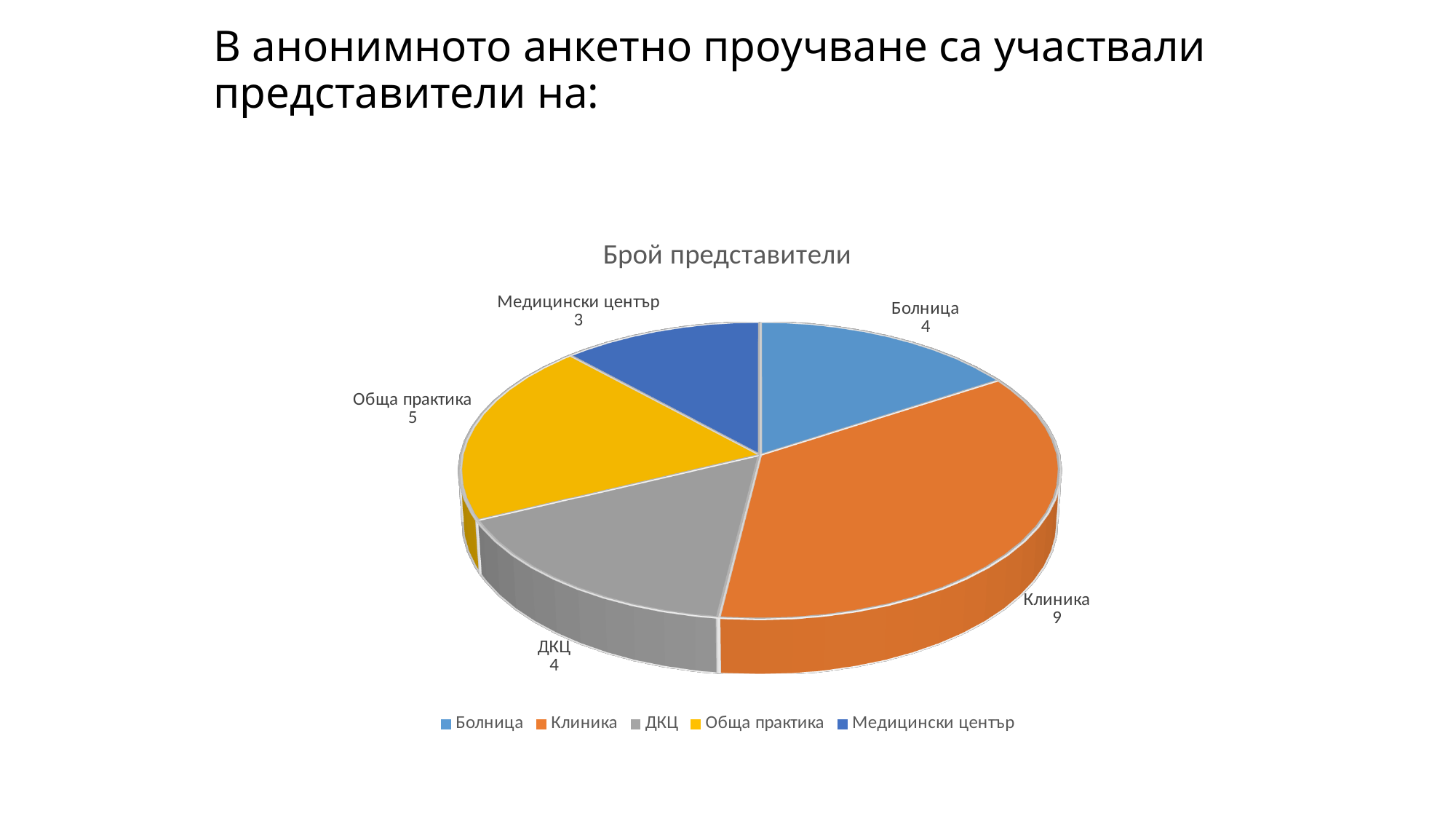
What is the title of the chart? Брой представители How many categories does the pie chart show? 5 What is the total of all slices in the pie chart? 25 Which category has the smallest slice? Медицински център What is the value for Клиника? 9 What is the value for Медицински център? 3 Which category has the largest slice? Клиника Which is larger, the value for Обща практика or the value for Медицински център? Обща практика What share of the pie does Клиника represent? 36% What is the value for Обща практика? 5 What kind of chart is shown on the slide? Pie chart What is the difference between the values for Клиника and Обща практика? 4